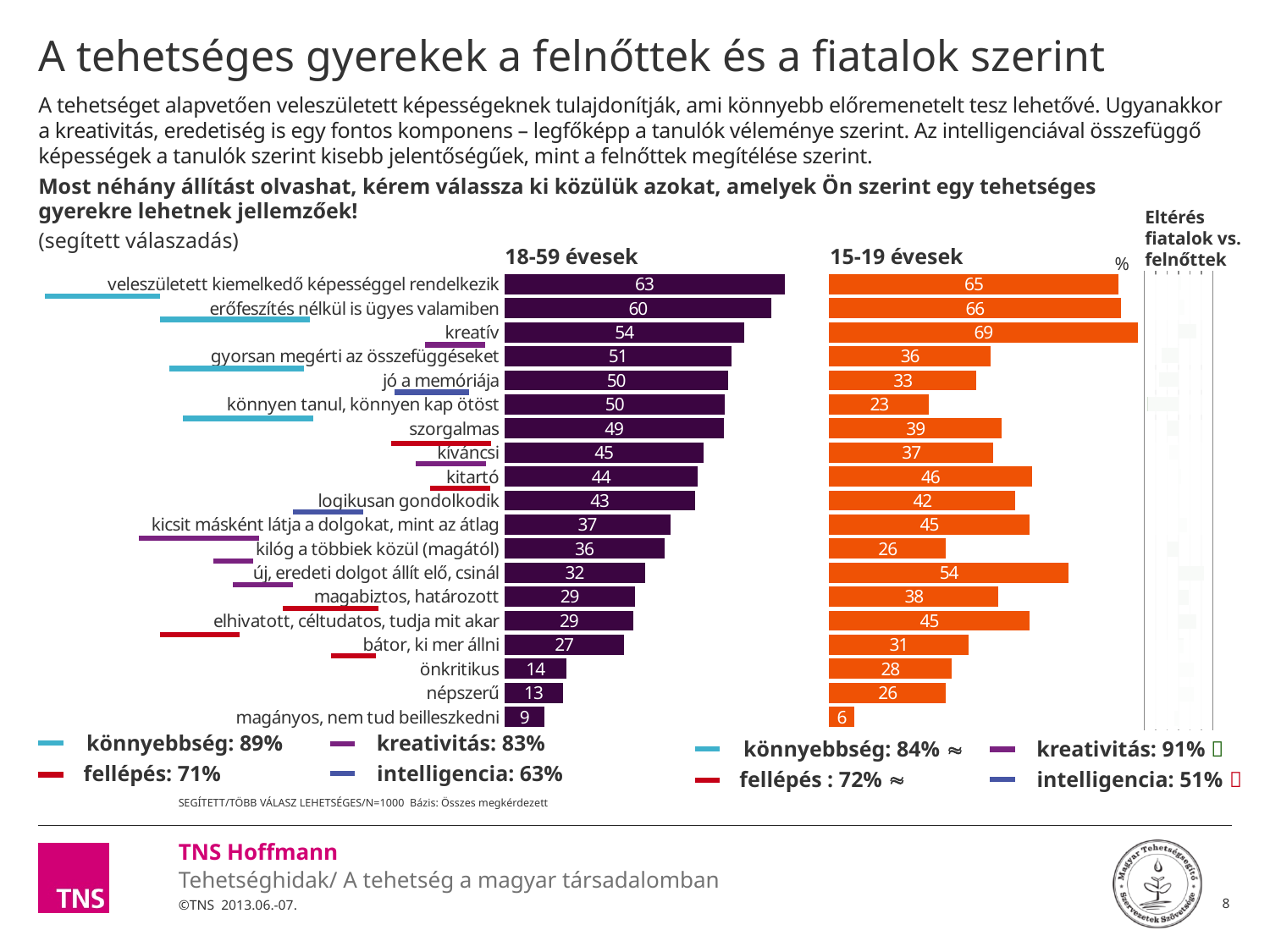
What is the difference between the 15-19 évesek value and the 18-59 évesek value for új, eredeti dolgot állít elő, csinál? 22 In the 15-19 évesek chart, what is the value for könnyen tanul, könnyen kap ötöst? 23 In the 18-59 évesek chart, what is the difference between erőfeszítés nélkül is ügyes valamiben and szorgalmas? 11 In the 18-59 évesek chart, which category has the highest value? veleszületett kiemelkedő képességgel rendelkezik What type of chart is used for the 18-59 évesek data? bar chart In the 18-59 évesek chart, what is the value for kreatív? 54 In the 18-59 évesek chart, which category has the lowest value? magányos, nem tud beilleszkedni In the 15-19 évesek chart, what is the value for önkritikus? 28 What colour are the bars in the 15-19 évesek chart? orange For jó a memóriája, which group has the larger value: 18-59 évesek or 15-19 évesek? 18-59 évesek In the 15-19 évesek chart, which category has the highest value? kreatív How many categories are shown in the 18-59 évesek chart? 19